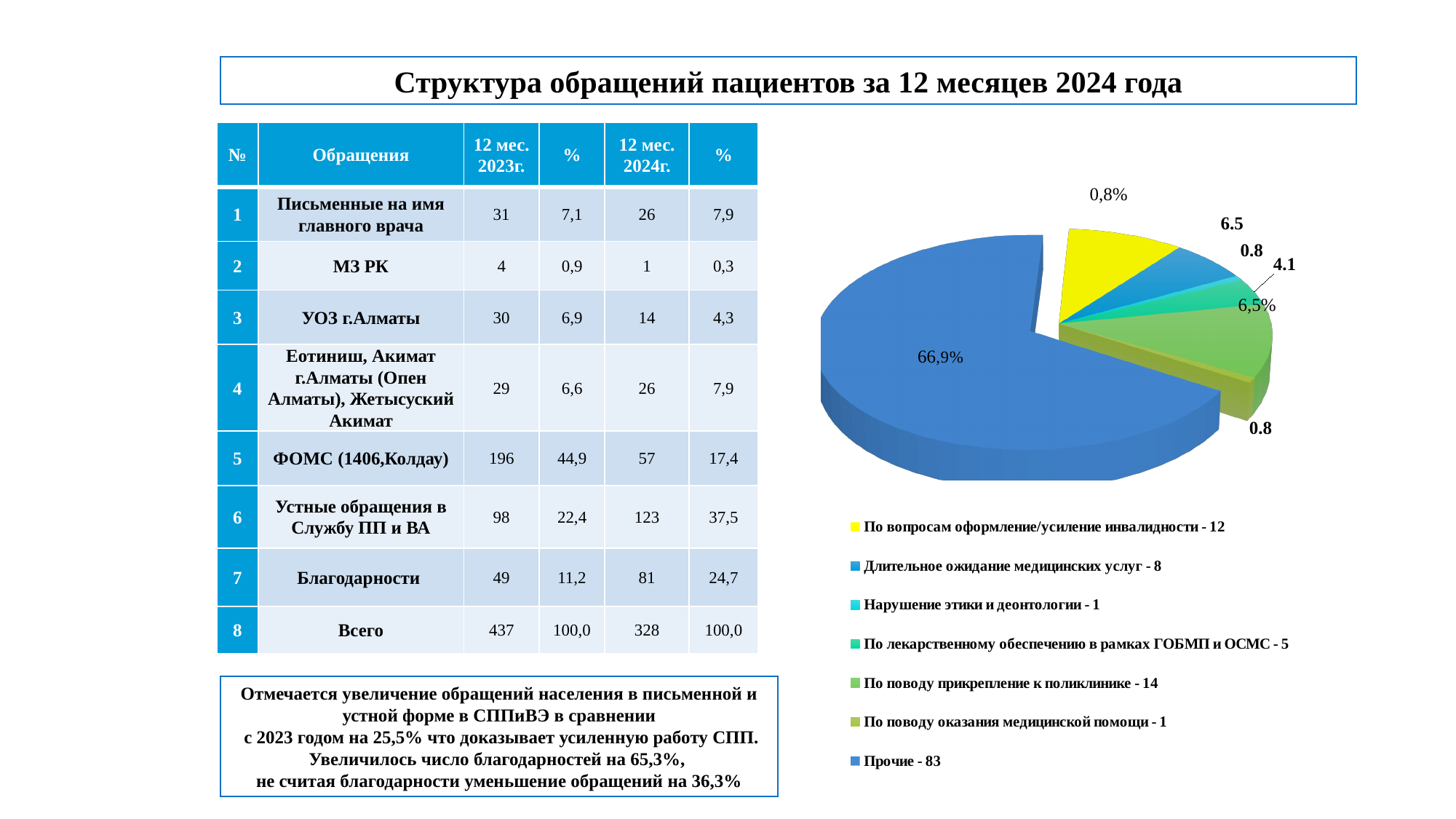
According to the legend, which is larger: "Длительное ожидание медицинских услуг" or "По лекарственному обеспечению в рамках ГОБМП и ОСМС"? Длительное ожидание медицинских услуг According to the legend, what is the difference between "По поводу прикрепление к поликлинике" and "По вопросам оформление/усиление инвалидности"? 2 What kind of chart is shown on the right side of the slide? pie chart In the pie chart legend, what is the number given for "По поводу прикрепление к поликлинике"? 14 In the pie chart legend, what is the number given for "Нарушение этики и деонтологии"? 1 What percentage label is shown on the largest (blue) slice of the pie chart? 66,9% What is the total of all the values listed in the pie chart legend? 124 How many categories does the legend of the pie chart list? 7 What colour is the slice for "По вопросам оформление/усиление инвалидности" in the pie chart? yellow In the pie chart legend, what is the number given for "Прочие"? 83 What colour is the slice for "Прочие" in the pie chart? blue Which category has the largest slice in the pie chart? Прочие